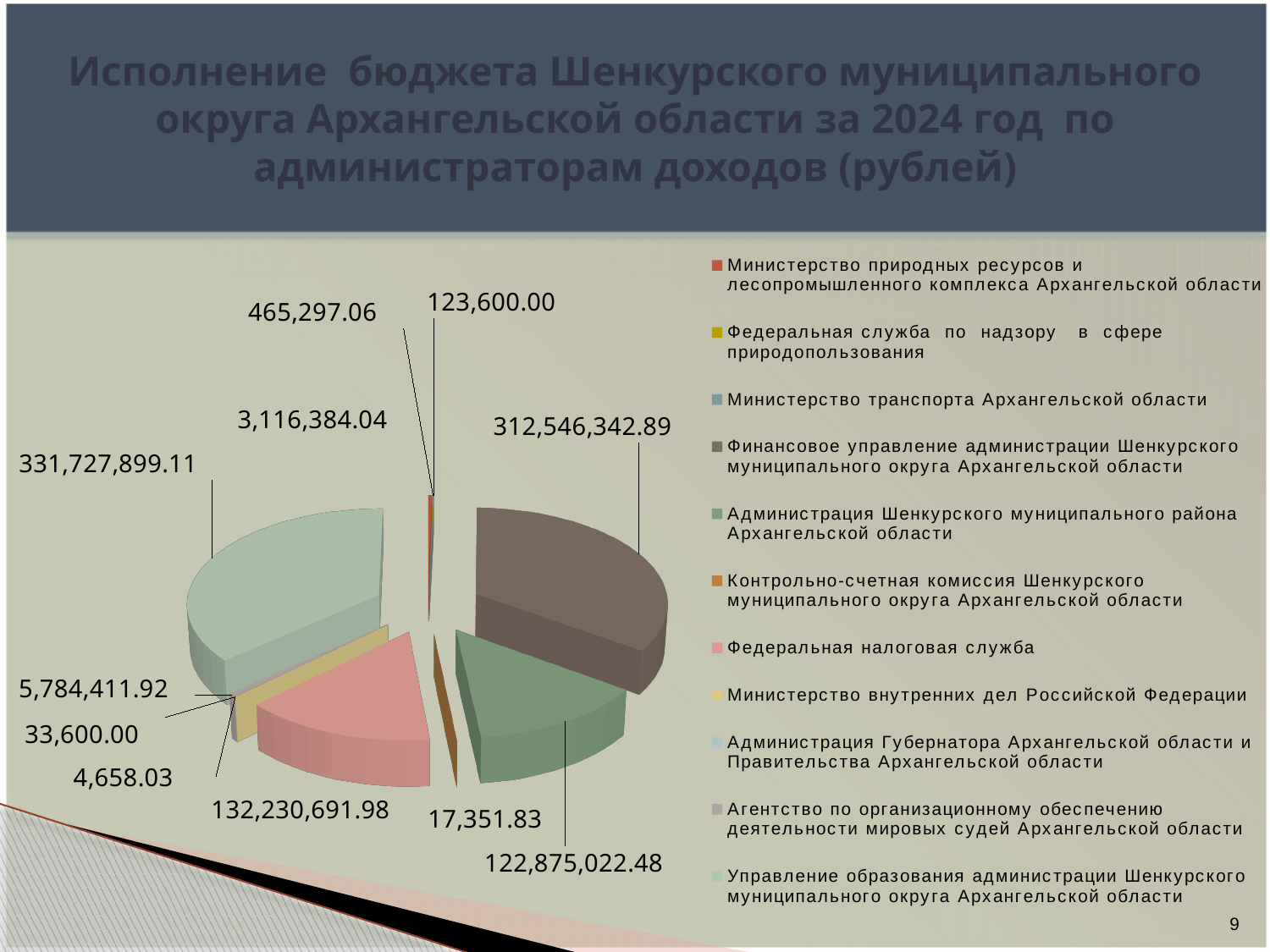
What year does the chart title say the budget execution data is for? 2024 What is the value for Финансовое управление администрации Шенкурского муниципального округа Архангельской области? 312,546,342.89 What kind of chart is shown on the slide? pie chart What is the value for Федеральная налоговая служба? 132,230,691.98 How many slices does the pie chart have? 11 How many series does the legend list? 11 What is the difference between the value for Управление образования администрации Шенкурского муниципального округа and the value for Финансовое управление администрации Шенкурского муниципального округа? 19,181,556.22 Which is larger: the value for Федеральная налоговая служба or the value for Администрация Шенкурского муниципального района Архангельской области? Федеральная налоговая служба What is the smallest value shown on the pie chart? 4,658.03 Which administrator has the largest slice of the pie? Управление образования администрации Шенкурского муниципального округа Архангельской области What is the value for Управление образования администрации Шенкурского муниципального округа Архангельской области? 331,727,899.11 What is the value for Администрация Шенкурского муниципального района Архангельской области? 122,875,022.48